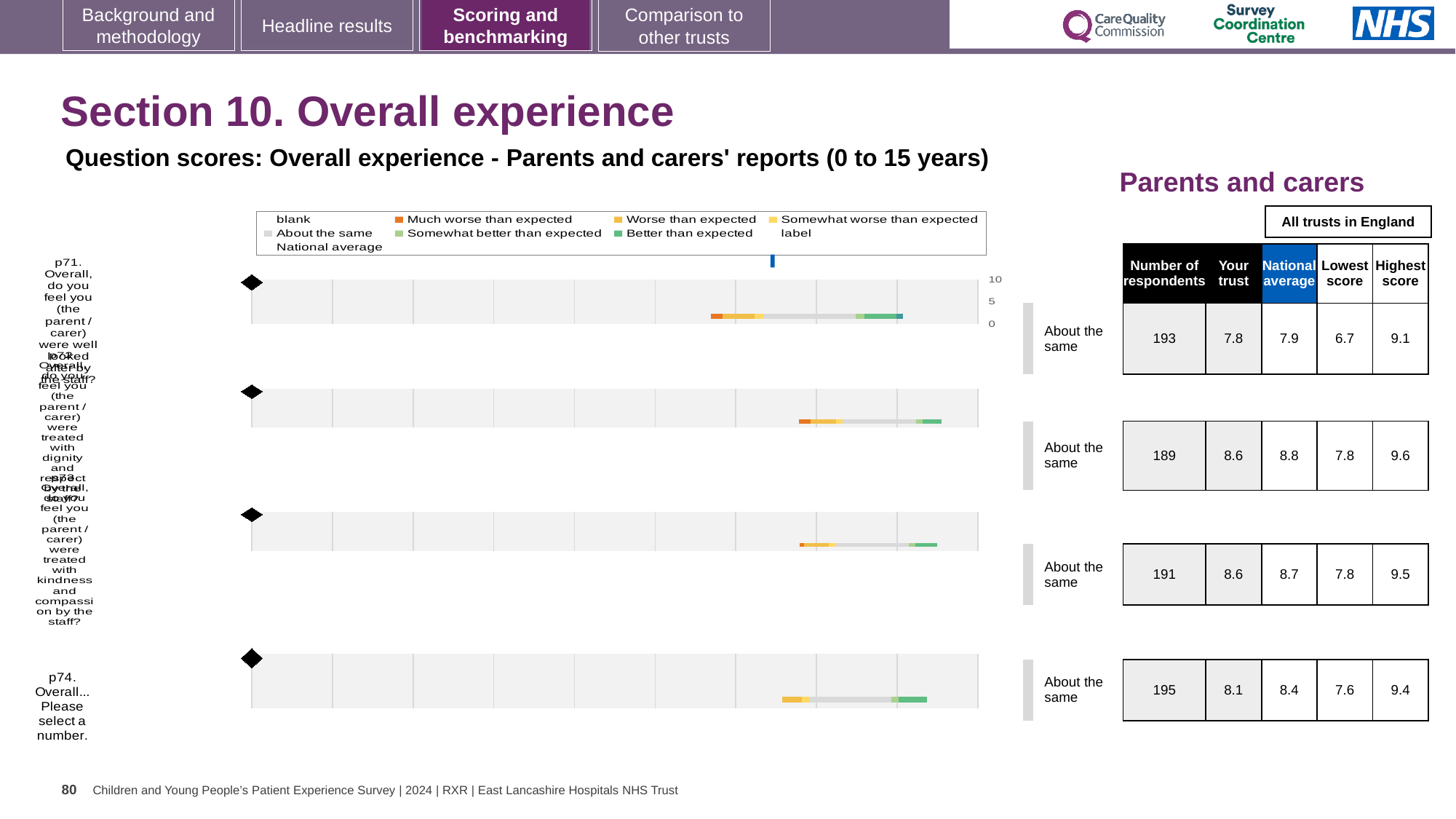
What is the lowest score among all trusts in England for question p71? 6.7 In the chart legend, which colour represents 'Much worse than expected'? orange How many questions (bars) are plotted in the chart? 4 What is the highest score among all trusts in England for question p74? 9.4 What is the national average score for question p71? 7.9 What is the 'Your trust' score for question p71 (Overall, do you feel you were well looked after by the staff?)? 7.8 What kind of chart is used to show the question scores on this slide? bar chart How many respondents answered question p74 (Overall... Please select a number)? 195 What is the difference between the national average (8.4) and the trust score (8.1) for question p74? 0.3 Which is larger for question p71: the trust score or the national average? national average In the chart legend, which colour represents 'Better than expected'? green What is the 'Your trust' score for question p74? 8.1